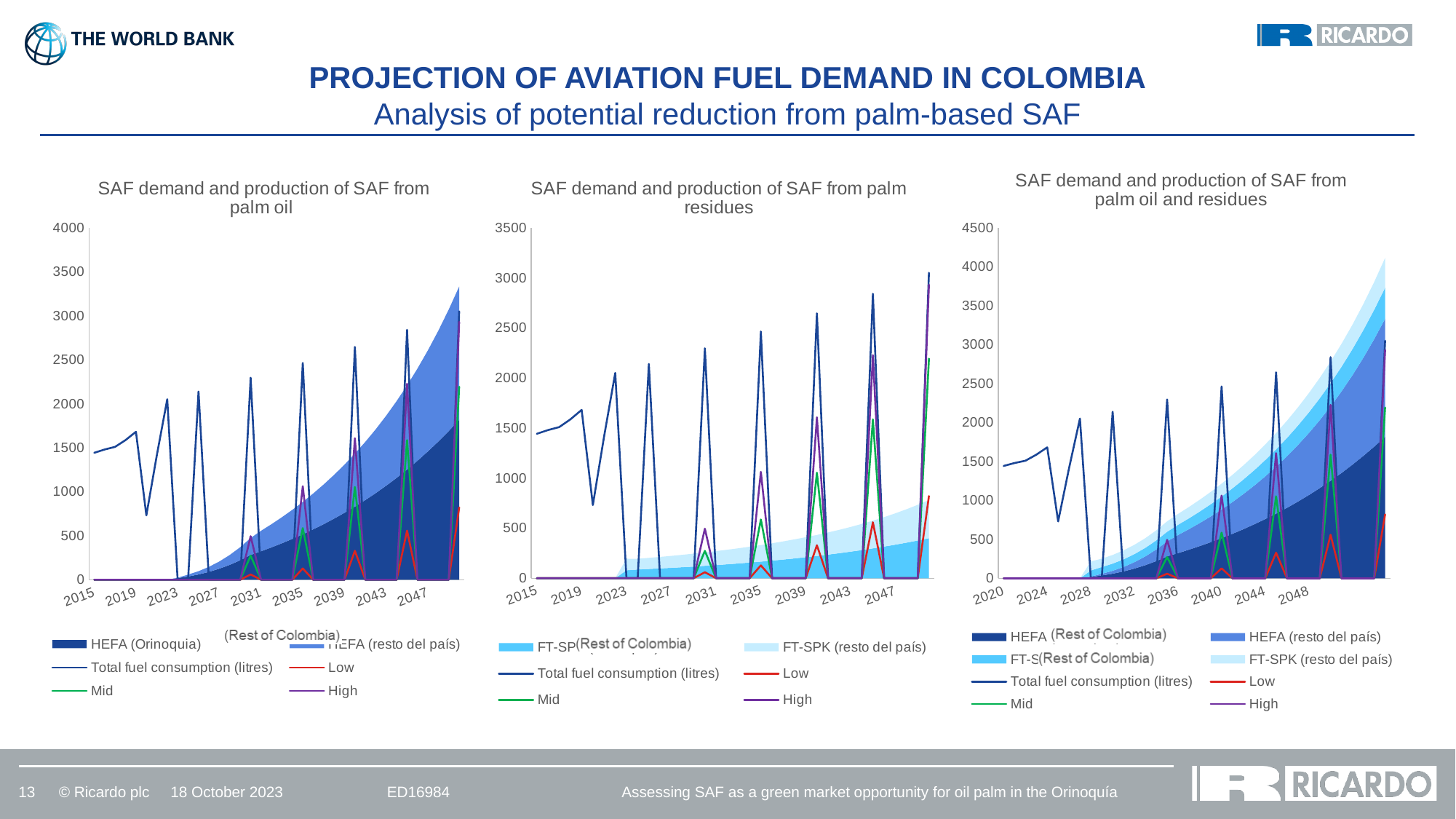
What kind of chart is the left chart titled 'SAF demand and production of SAF from palm oil'? Combined area and line chart In the left chart, 'SAF demand and production of SAF from palm oil', which line reaches higher at its final peak: High or Low? High How many series does the legend list for the middle chart, 'SAF demand and production of SAF from palm residues'? 6 How many series does the legend list for the right chart, 'SAF demand and production of SAF from palm oil and residues'? 8 In the right chart, 'SAF demand and production of SAF from palm oil and residues', is the Low line peak near 2048 greater or less than 1000? less In the middle chart, 'SAF demand and production of SAF from palm residues', does the FT-SPK (resto del país) area rise or fall as the years increase? Rise What is the highest value shown on the vertical axis of the right chart, 'SAF demand and production of SAF from palm oil and residues'? 4500 How many series does the legend list for the left chart, 'SAF demand and production of SAF from palm oil'? 6 What is the title of the middle chart on the slide? SAF demand and production of SAF from palm residues In the left chart, 'SAF demand and production of SAF from palm oil', is the Total fuel consumption (litres) value in 2015 greater or less than 1000? greater In the middle chart, 'SAF demand and production of SAF from palm residues', is the highest peak of the Total fuel consumption (litres) line greater or less than 2500? greater In the left chart, 'SAF demand and production of SAF from palm oil', does the HEFA (Orinoquia) area rise or fall as the years increase? Rise